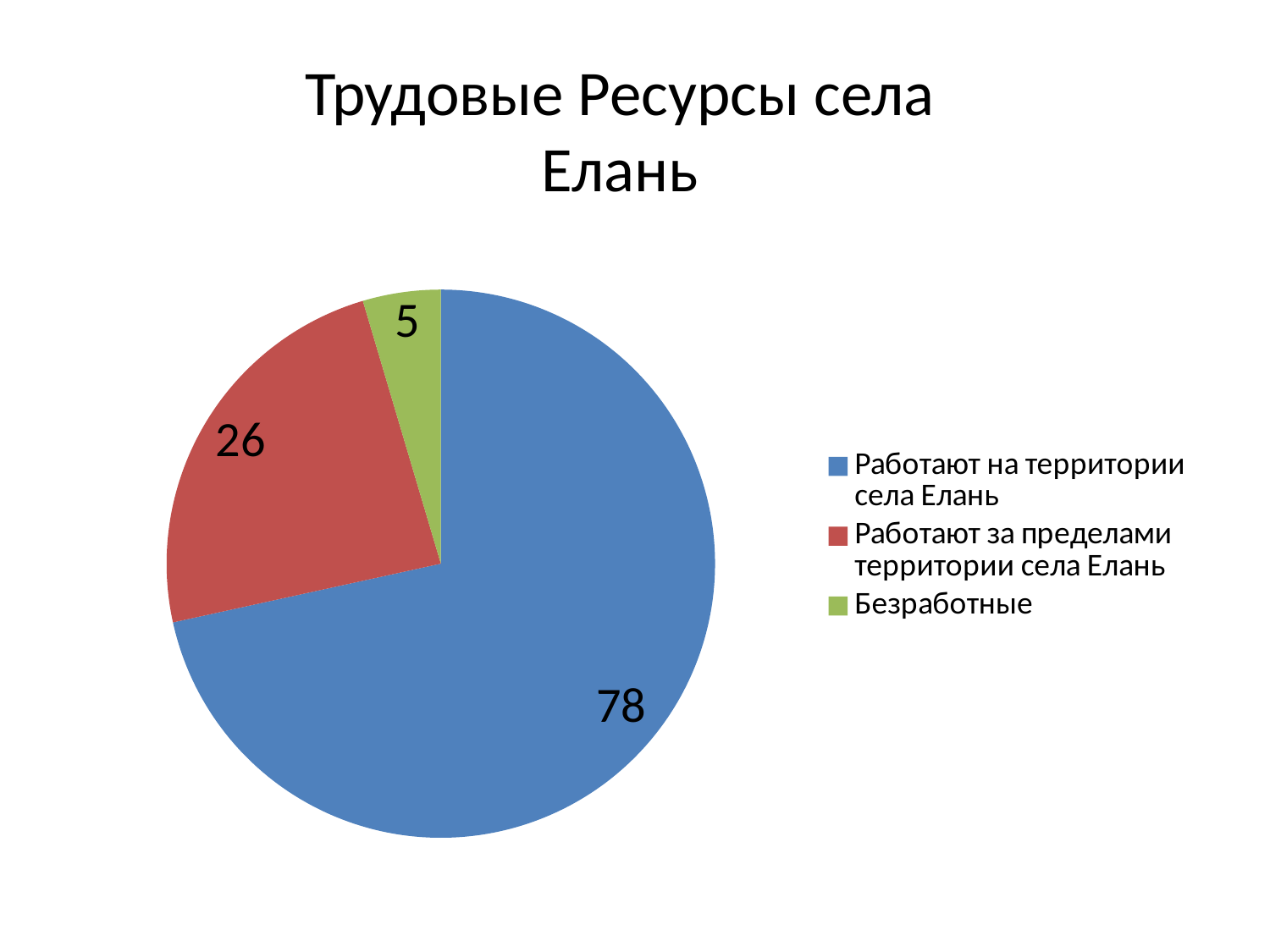
What is the value for "Работают за пределами территории села Елань"? 26 Which category has the largest slice of the pie? Работают на территории села Елань What is the value for "Безработные"? 5 What is the difference between the values for "Работают на территории села Елань" and "Работают за пределами территории села Елань"? 52 What type of chart is shown on the slide? pie chart What is the value for "Работают на территории села Елань"? 78 Which is larger: the value for "Работают за пределами территории села Елань" or the value for "Безработные"? Работают за пределами территории села Елань How many categories does the pie chart have? 3 Which category has the smallest slice of the pie? Безработные What is the total of all the slices in the pie chart? 109 What is the difference between the values for "Работают за пределами территории села Елань" and "Безработные"? 21 What is the title of the chart on the slide? Трудовые Ресурсы села Елань